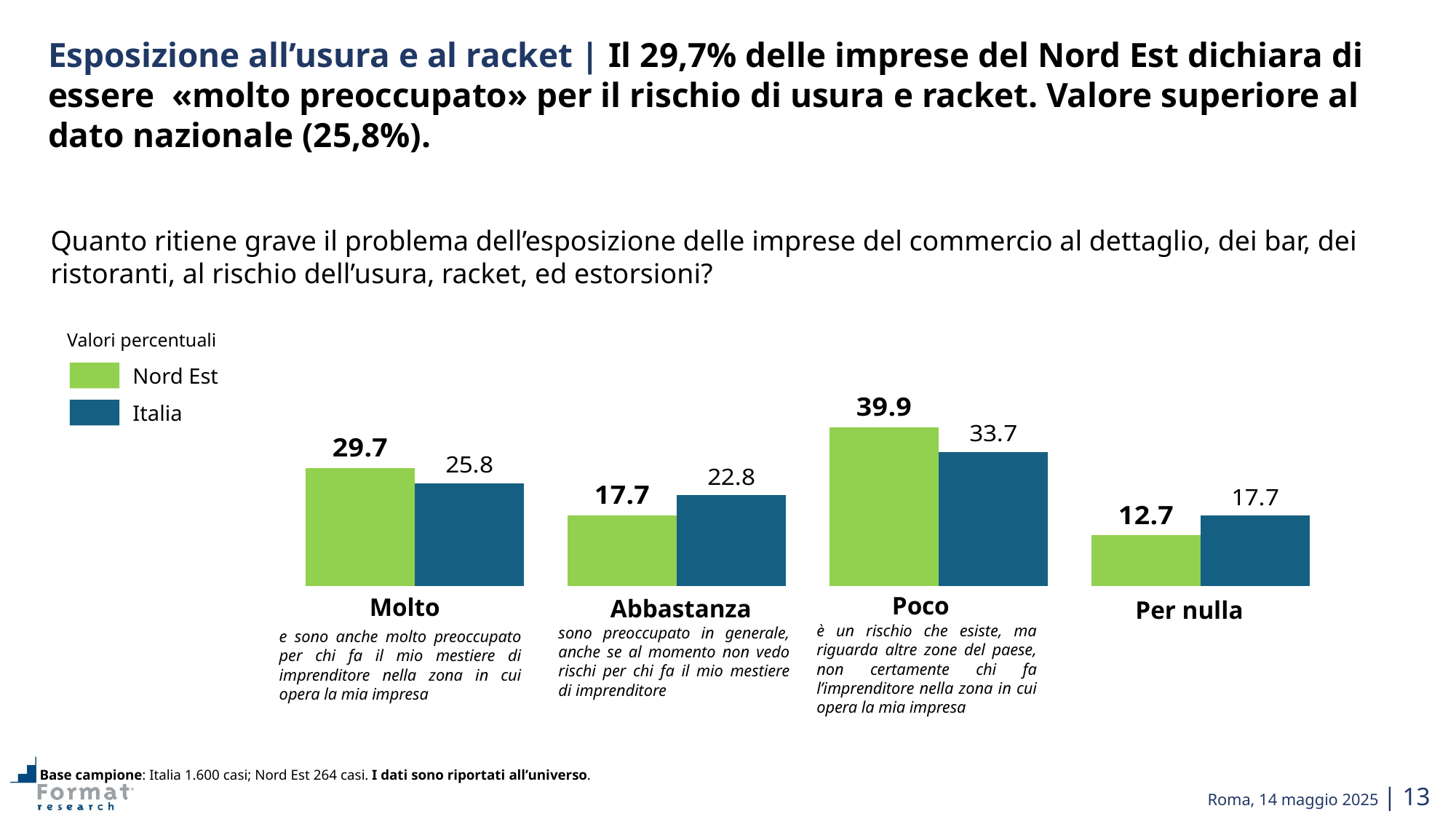
What kind of chart is shown on the slide? Bar chart What is the Nord Est value for the 'Molto' category? 29.7 Which category has the lowest Italia value? Per nulla For the 'Abbastanza' category, which is larger: the Nord Est value or the Italia value? Italia How many categories are shown on the x axis of the chart? 4 Which category has the highest Nord Est value? Poco What is the difference between the Nord Est value for 'Molto' and the Nord Est value for 'Abbastanza'? 12.0 Which colour represents the Italia series in the legend? Dark blue What is the Italia value for the 'Poco' category? 33.7 What is the Nord Est value for 'Per nulla'? 12.7 How many series does the legend list? 2 What is the difference between the Nord Est and Italia values for 'Poco'? 6.2